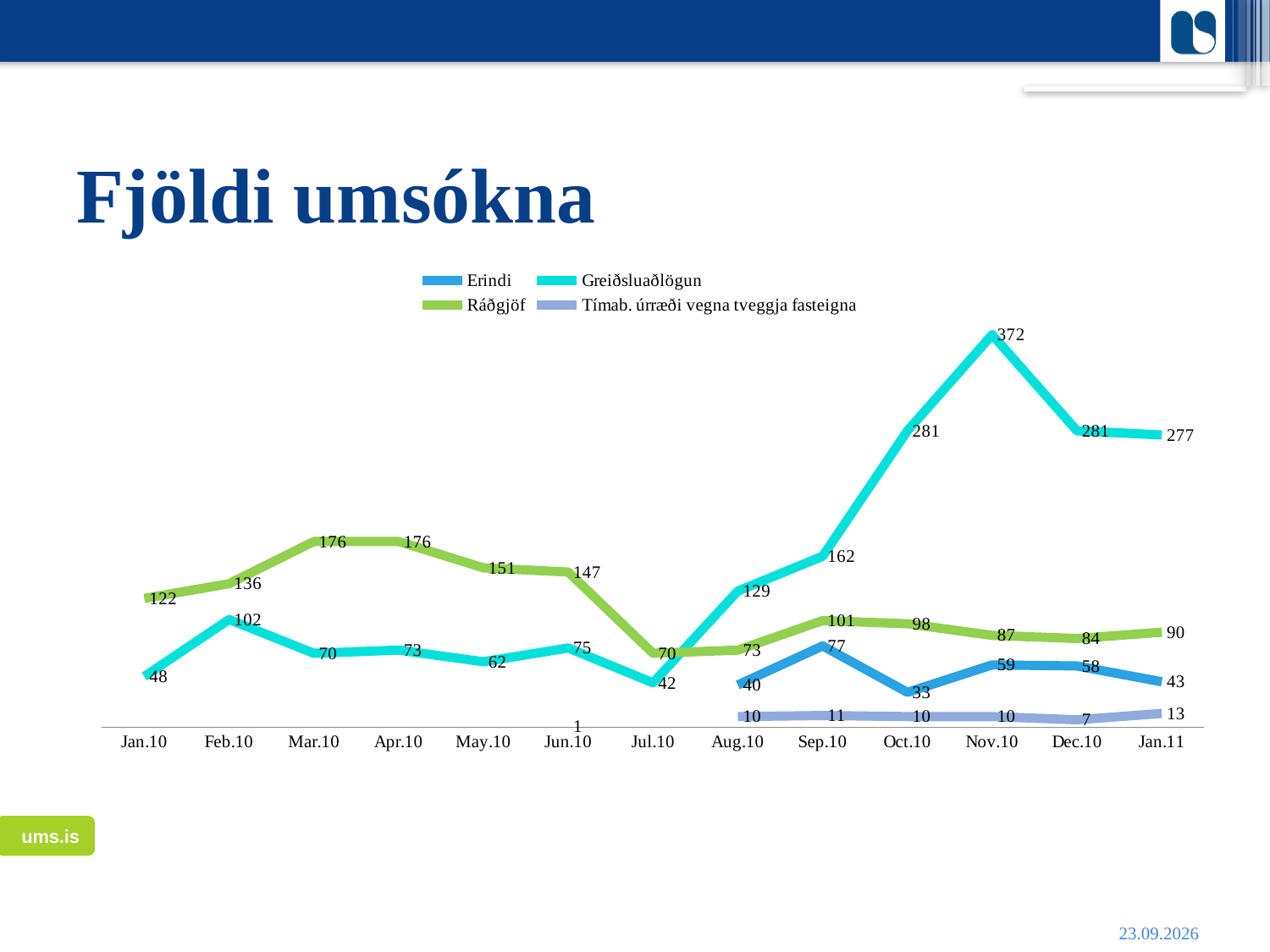
In which month does the Greiðsluaðlögun series reach its highest value? Nov.10 How many series does the legend list? 4 Does the Greiðsluaðlögun series rise or fall from Jul.10 to Nov.10? rise What kind of chart is shown on the slide? line chart What is the difference between the Greiðsluaðlögun values in Nov.10 and Dec.10? 91 What is the value of Greiðsluaðlögun in Nov.10? 372 How many months are shown on the x axis? 13 What is the value of Ráðgjöf in Jan.10? 122 In which month is the Erindi series at its lowest? Oct.10 What is the value of Erindi in Sep.10? 77 What is the value of Tímab. úrræði vegna tveggja fasteigna in Jan.11? 13 In Sep.10, which is larger: Greiðsluaðlögun or Ráðgjöf? Greiðsluaðlögun